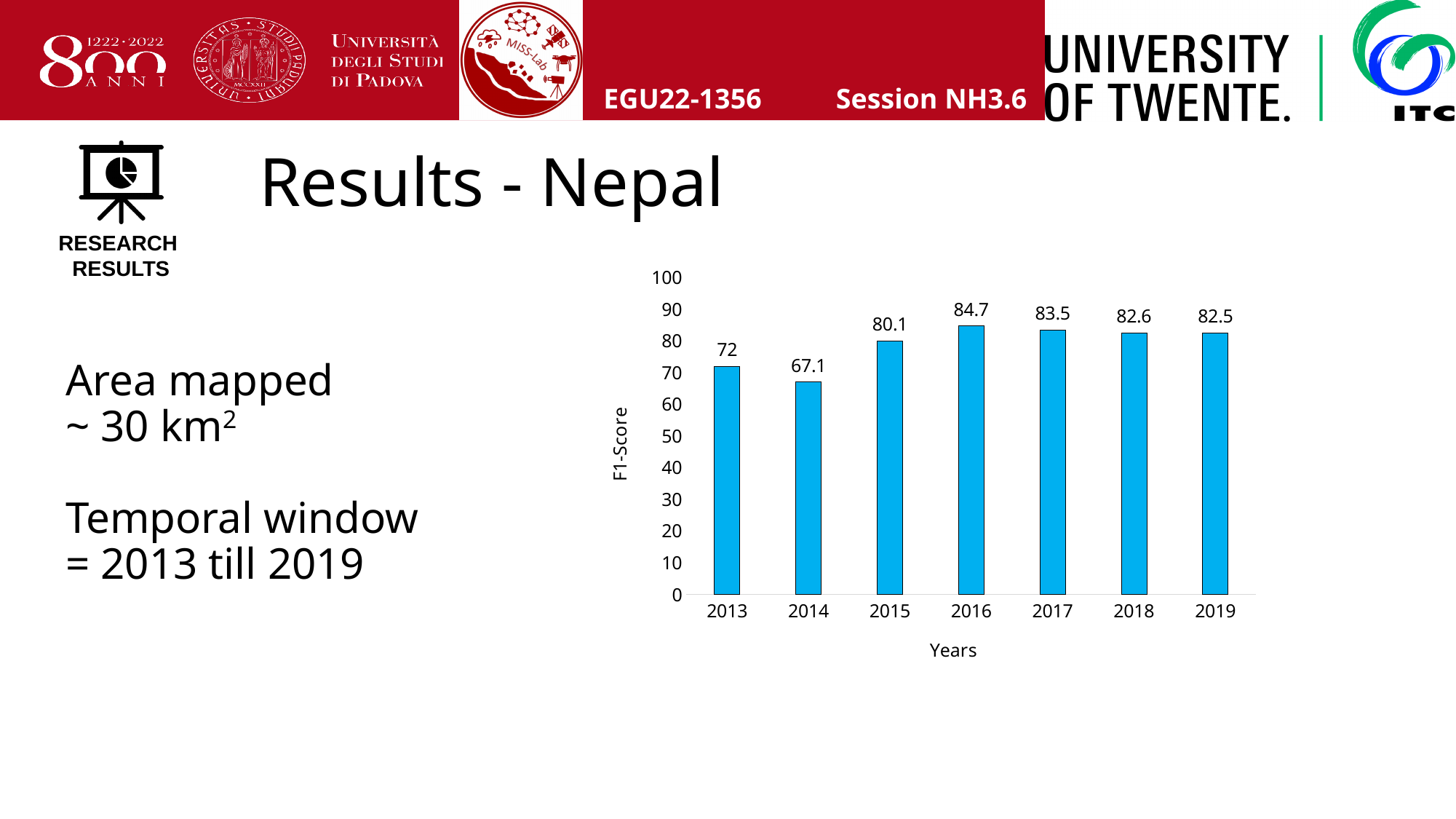
What is the difference between the F1-Score in 2015 and in 2013? 8.1 Which year has a higher F1-Score, 2013 or 2015? 2015 What is the F1-Score for 2013? 72 Which year has the lowest F1-Score? 2014 What is the F1-Score for 2019? 82.5 What kind of chart is shown on the slide? bar chart How many years are shown on the x axis of the chart? 7 What is the label of the y axis of the chart? F1-Score Is the F1-Score for 2014 greater or less than 70? less What is the difference between the F1-Score in 2016 and in 2014? 17.6 What is the F1-Score for 2016? 84.7 Which year has the highest F1-Score? 2016